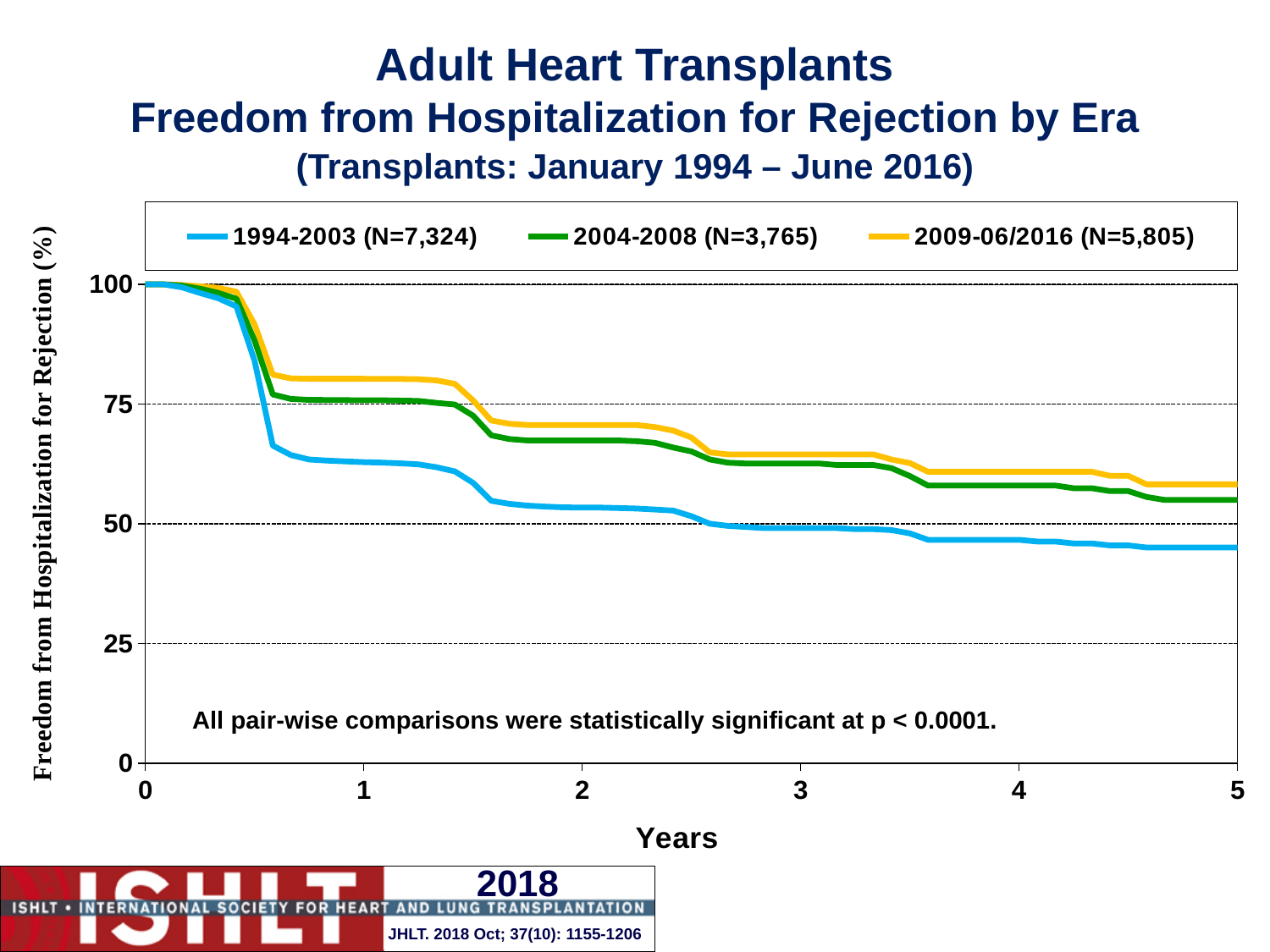
How many series does the legend list? 3 Which era series has the highest freedom from hospitalization for rejection across the follow-up period? 2009-06/2016 Is the value for the 1994-2003 series at 1 year greater or less than 75? less Is the value for the 2009-06/2016 series at 1 year greater or less than 75? greater Which era series has the lowest freedom from hospitalization for rejection across the follow-up period? 1994-2003 What is the N shown in the legend for the 2004-2008 series? N=3,765 Is the value for the 1994-2003 series at 5 years greater or less than 50? less What kind of chart is shown on the slide? line chart Do the values for the 1994-2003 series rise or fall as years increase? fall Do the values for the 2009-06/2016 series rise or fall along the x axis? fall At 5 years, which series has the higher value: 2009-06/2016 or 1994-2003? 2009-06/2016